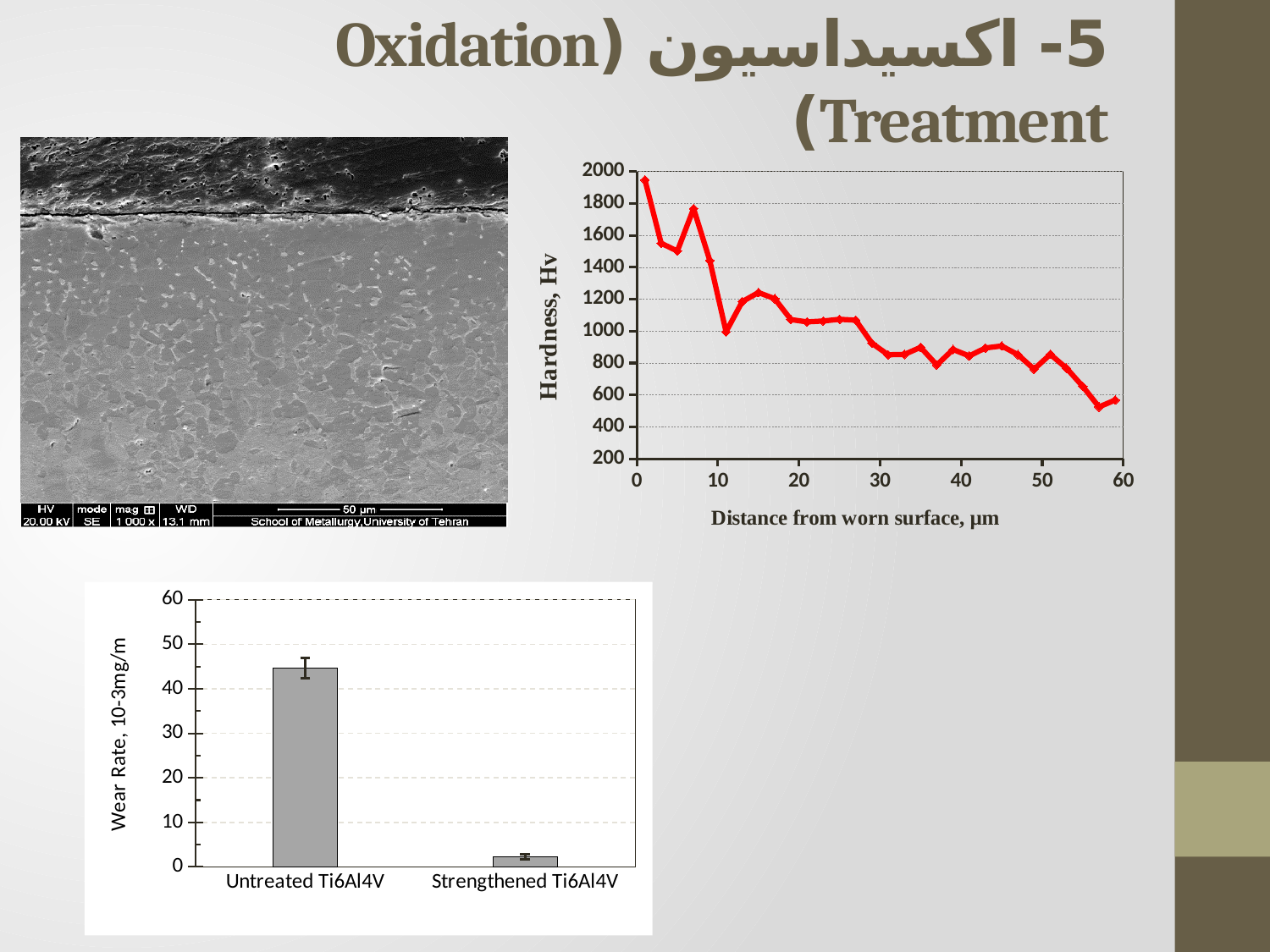
In the hardness line chart, do the hardness values generally rise or fall as the distance from the worn surface increases? fall In the wear rate bar chart, is the value for Untreated Ti6Al4V greater or less than 40? greater In the wear rate bar chart, which category has the highest wear rate? Untreated Ti6Al4V In the hardness line chart, is the hardness at about 30 µm from the worn surface greater or less than 1000? less In the hardness line chart, is the hardness at the point closest to the worn surface (near 0 µm) greater or less than 1800? greater In the wear rate bar chart, how many categories are shown? 2 What kind of chart is the chart at the bottom left of the slide showing wear rate? bar chart In the wear rate bar chart, which category has the lowest wear rate? Strengthened Ti6Al4V In the wear rate bar chart, which has the larger wear rate, Untreated Ti6Al4V or Strengthened Ti6Al4V? Untreated Ti6Al4V What is the label of the x axis of the hardness line chart? Distance from worn surface, µm What kind of chart is the chart at the top right of the slide showing hardness? line chart